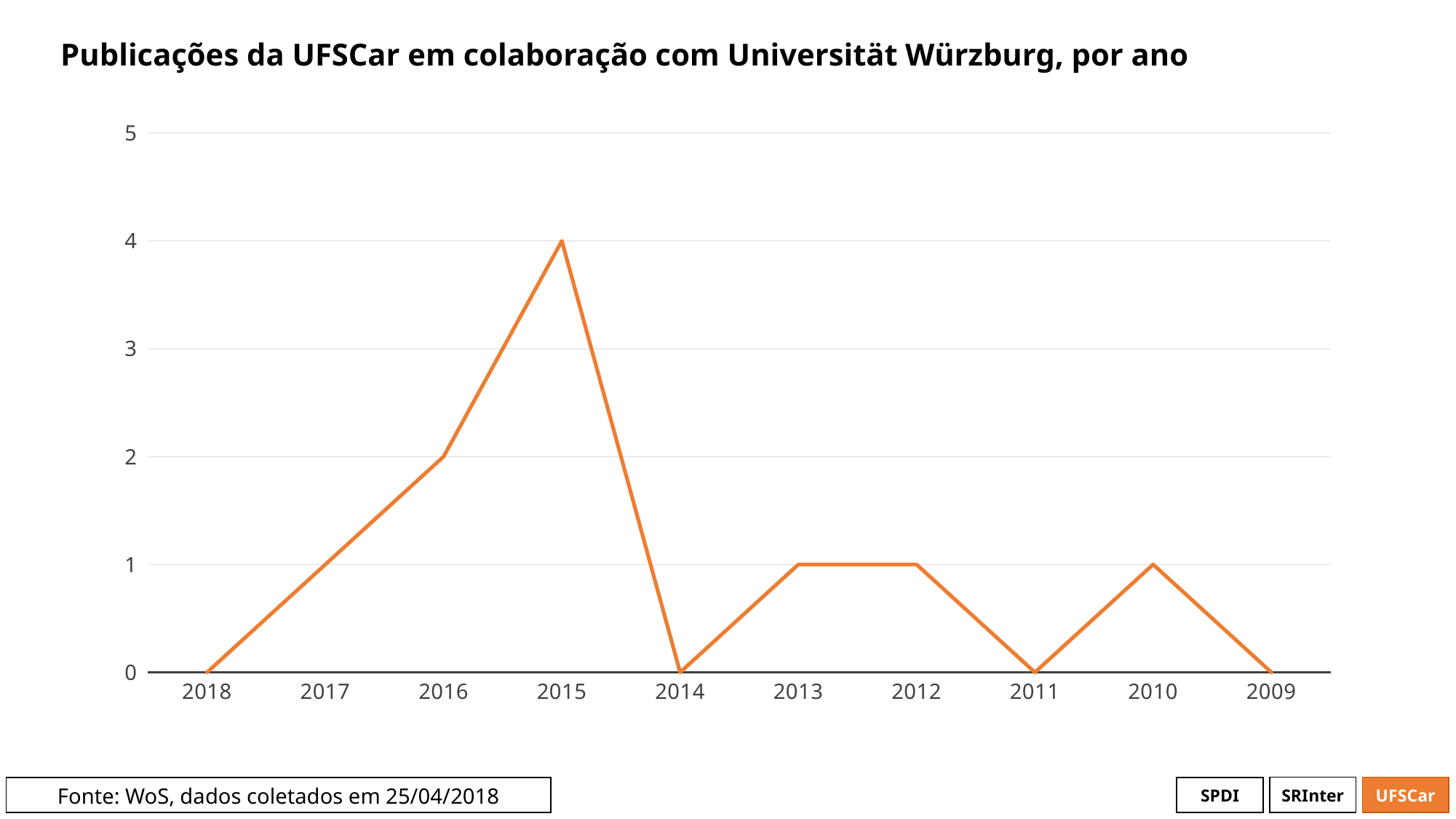
Do the values rise or fall from 2018 to 2015 along the x axis? rise How many years are plotted on the x axis? 10 What is the value for 2010? 1 What is the difference between the values for 2015 and 2016? 2 Is the value for 2015 greater or less than 3? greater What type of chart is shown on the slide? line chart What is the value for 2014? 0 Which is larger, the value for 2017 or the value for 2016? 2016 What is the title of the chart? Publicações da UFSCar em colaboração com Universität Würzburg, por ano What is the value for 2015? 4 What is the value for 2016? 2 Which year has the highest value? 2015